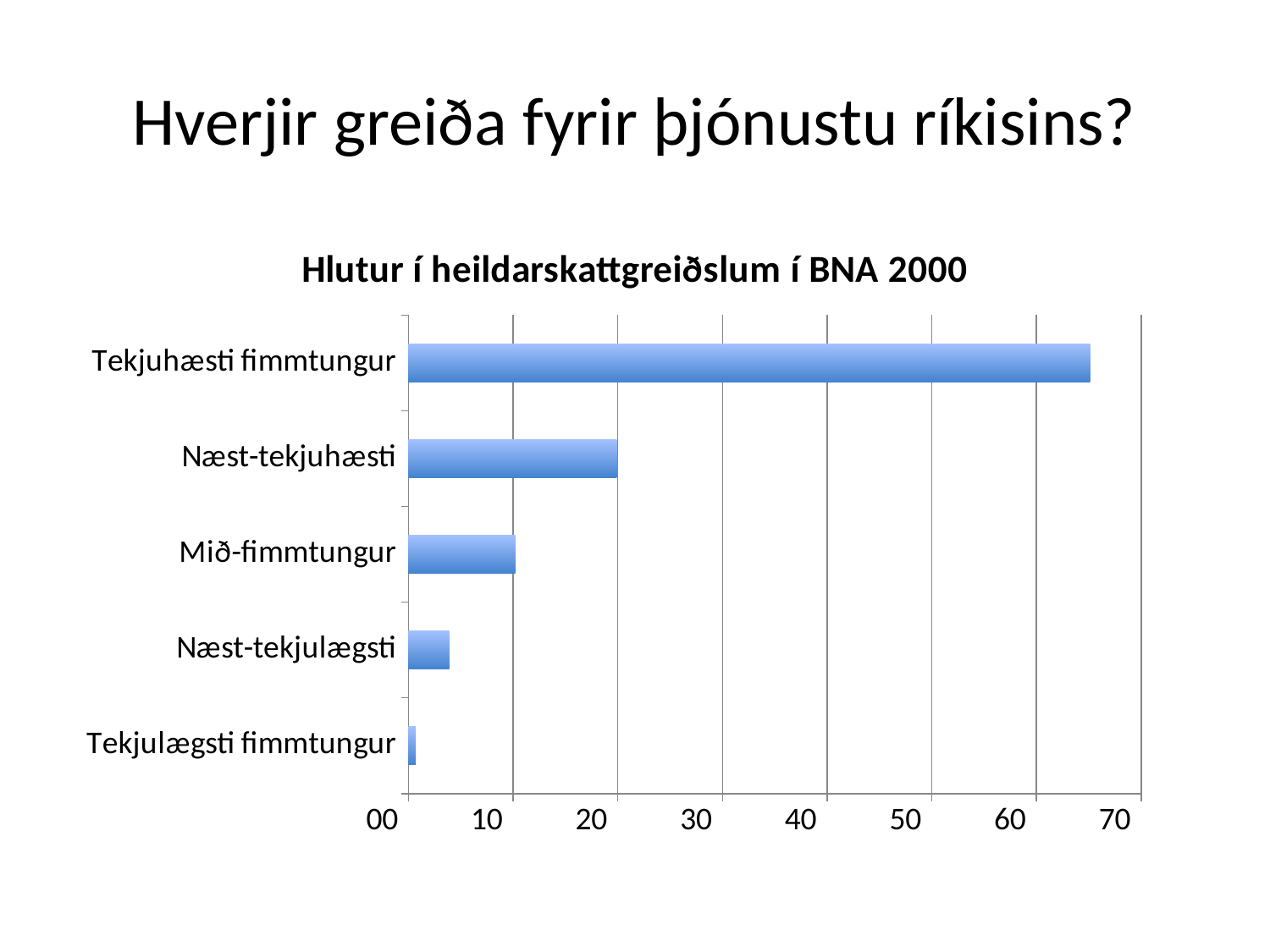
What kind of chart is shown on the slide? bar chart How many categories are shown in the chart? 5 Is the value for Næst-tekjuhæsti greater or less than 30? less Which category has the highest value? Tekjuhæsti fimmtungur Which category has the lowest value? Tekjulægsti fimmtungur Is the value for Tekjuhæsti fimmtungur greater or less than 60? greater Is the value for Mið-fimmtungur greater or less than 20? less What is the title of the chart? Hlutur í heildarskattgreiðslum í BNA 2000 Which is larger, the value for Næst-tekjulægsti or the value for Tekjulægsti fimmtungur? Næst-tekjulægsti Which is larger, the value for Næst-tekjuhæsti or the value for Mið-fimmtungur? Næst-tekjuhæsti